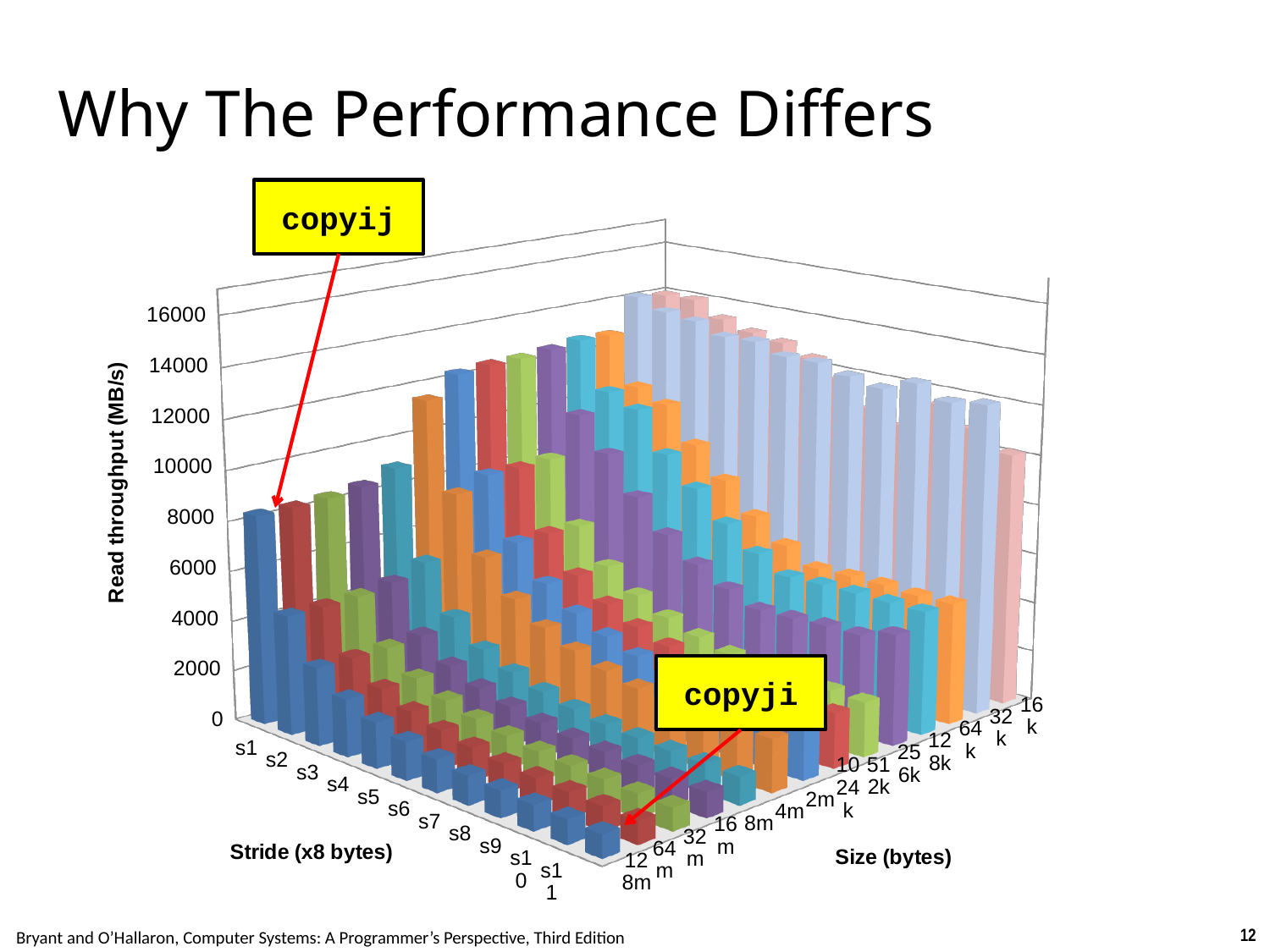
Is the read throughput for stride s1 at size 32k greater or less than 12000? greater How many stride categories (s1 through s11) are plotted along the stride axis? 11 Which stride has the highest read throughput at size 128m, s1 or s11? s1 What is the label of the stride axis? Stride (x8 bytes) Is the read throughput for stride s11 at size 128m greater or less than 2000? less What kind of chart is shown on the slide? 3D bar chart Is the read throughput for stride s1 at size 128m greater or less than 6000? greater How many size categories are plotted along the Size (bytes) axis? 14 What is the label of the vertical axis? Read throughput (MB/s) What is the highest tick value shown on the Read throughput axis? 16000 At size 128m, does read throughput rise or fall as the stride increases from s1 to s11? fall